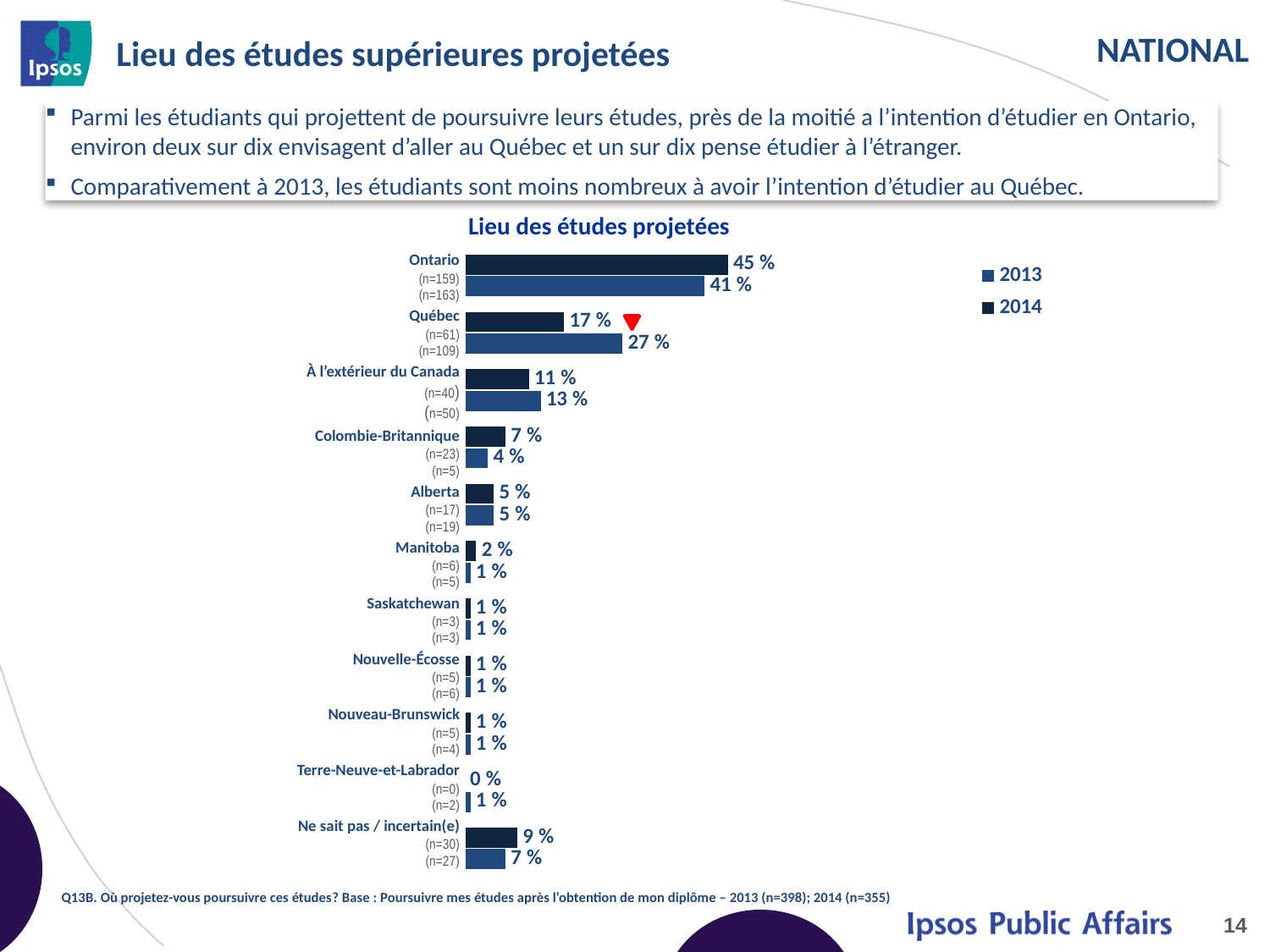
What is the value of the lower (lighter blue) bar for À l'extérieur du Canada? 13 % What is the difference between the two bars for Québec (17 % and 27 %)? 10 % What type of chart is shown on the slide? bar chart How many series does the chart legend list? 2 What is the value of the upper (dark navy) bar for Ontario? 45 % What are the two entries in the chart legend? 2013 and 2014 How many categories are plotted on the chart? 11 For Québec, which bar is larger, the upper (dark navy) bar or the lower (lighter blue) bar? the lower (lighter blue) bar What is the difference between the two bars for Ontario (45 % and 41 %)? 4 % What is the value of the upper (dark navy) bar for Ne sait pas / incertain(e)? 9 % What is the value of the lower (lighter blue) bar for Québec? 27 % Which category has the highest values on the chart? Ontario